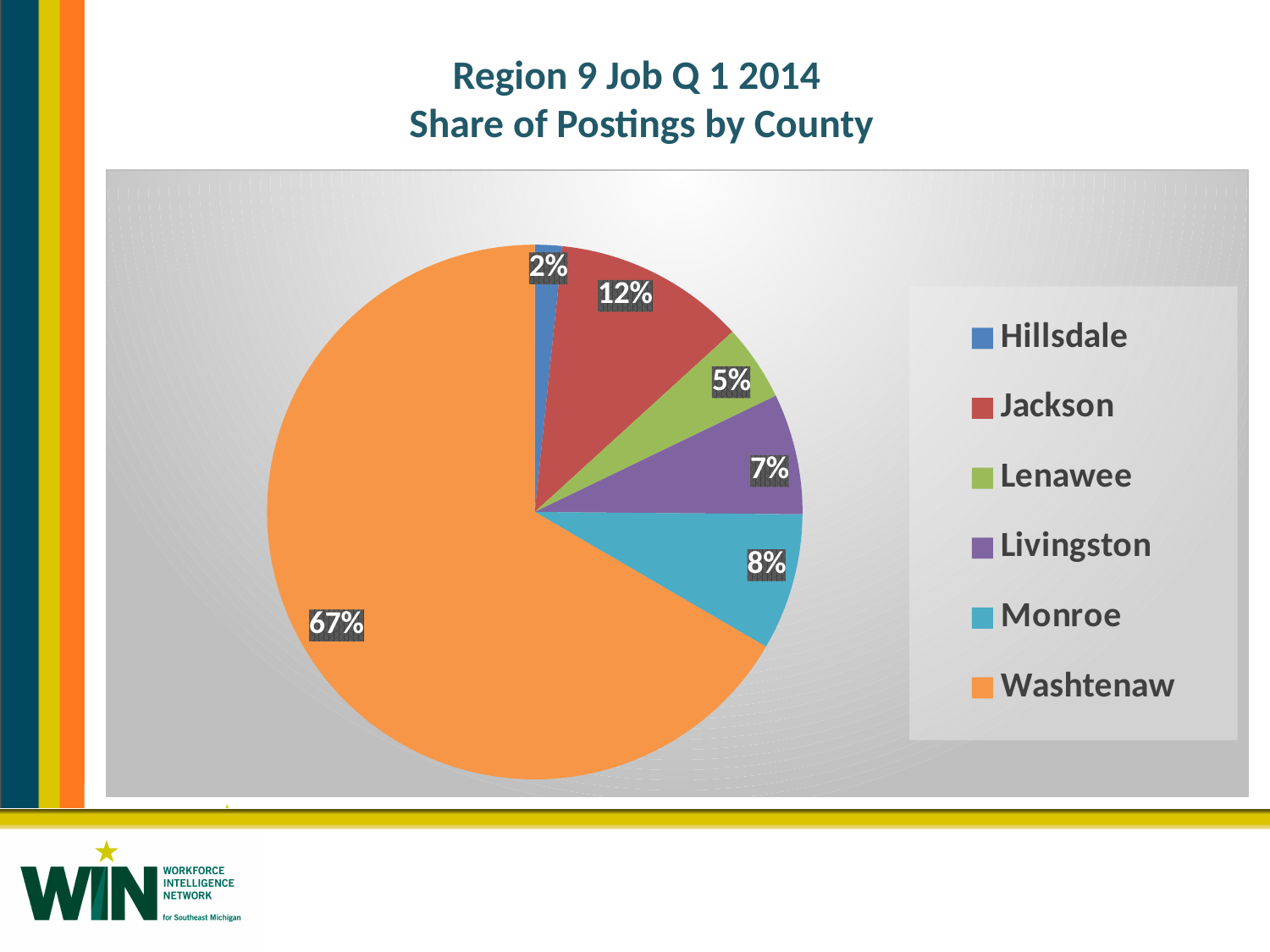
What share of postings does Jackson have? 12% What share of postings does Lenawee have? 5% What is the difference in share between Jackson and Monroe? 4% Which has a larger share of postings, Livingston or Lenawee? Livingston What kind of chart is shown on the slide? Pie chart What share of postings does Washtenaw have? 67% Which county has the largest share of postings? Washtenaw What share of postings does Livingston have? 7% Which county has the smallest share of postings? Hillsdale What is the title of the chart? Region 9 Job Q 1 2014 Share of Postings by County How many counties are shown in the pie chart? 6 What share of postings does Monroe have? 8%